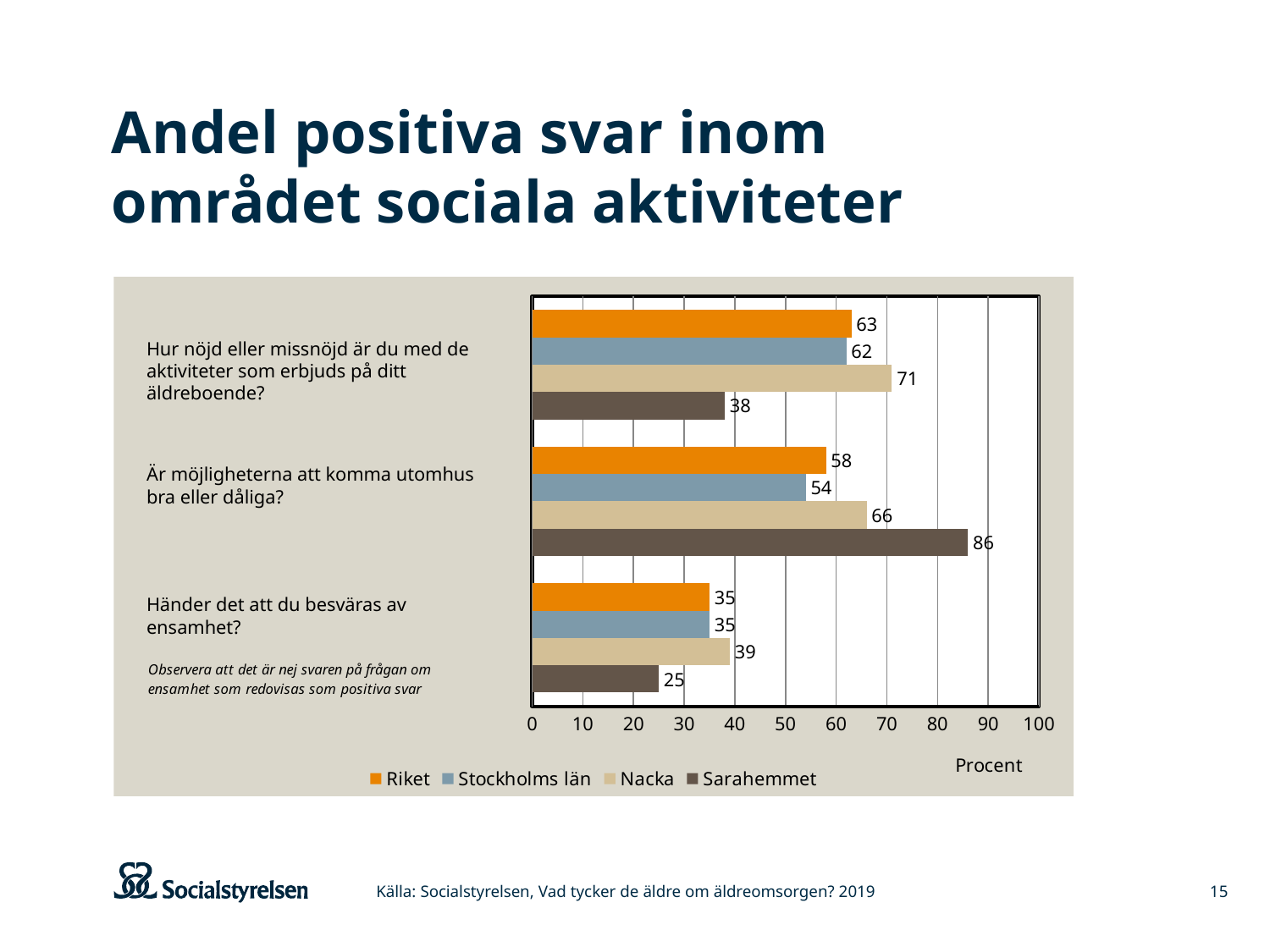
What is the value for Riket on the question "Händer det att du besväras av ensamhet?"? 35 What is the label of the x axis? Procent Which is larger on the question "Hur nöjd eller missnöjd är du med de aktiviteter som erbjuds på ditt äldreboende?": Riket or Sarahemmet? Riket How many question categories are plotted on the chart? 3 Which series has the highest value on the question "Hur nöjd eller missnöjd är du med de aktiviteter som erbjuds på ditt äldreboende?"? Nacka Which series has the lowest value on the question "Händer det att du besväras av ensamhet?"? Sarahemmet What is the value for Nacka on the question "Hur nöjd eller missnöjd är du med de aktiviteter som erbjuds på ditt äldreboende?"? 71 What kind of chart is shown on the slide? bar chart What is the difference between Riket and Stockholms län on the question "Är möjligheterna att komma utomhus bra eller dåliga?"? 4 What is the difference between Sarahemmet and Nacka on the question "Är möjligheterna att komma utomhus bra eller dåliga?"? 20 How many series does the legend list? 4 What is the value for Sarahemmet on the question "Är möjligheterna att komma utomhus bra eller dåliga?"? 86